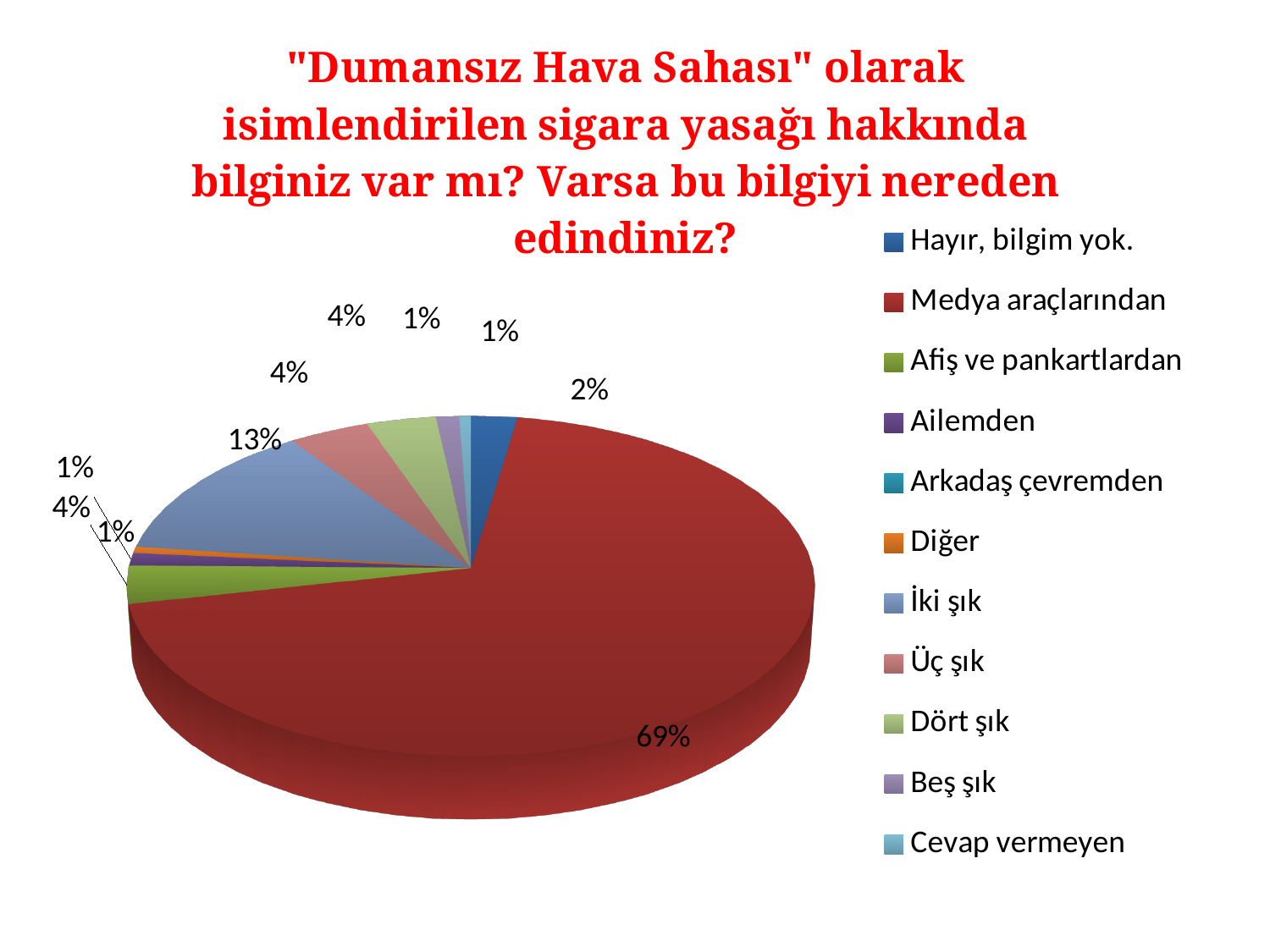
What is the value for "Hayır, bilgim yok."? 2% Which category has the largest share of the pie? Medya araçlarından What share of the pie does "Medya araçlarından" have? 69% What is the value for "Beş şık"? 1% What colour is the slice for "Medya araçlarından"? red What is the value for "Dört şık"? 4% What is the difference in percentage points between "Medya araçlarından" and "İki şık"? 56 What is the value for "Üç şık"? 4% How many entries does the legend list? 11 Which is larger, "İki şık" or "Hayır, bilgim yok."? İki şık What is the value for "İki şık"? 13% What kind of chart is shown on the slide? pie chart